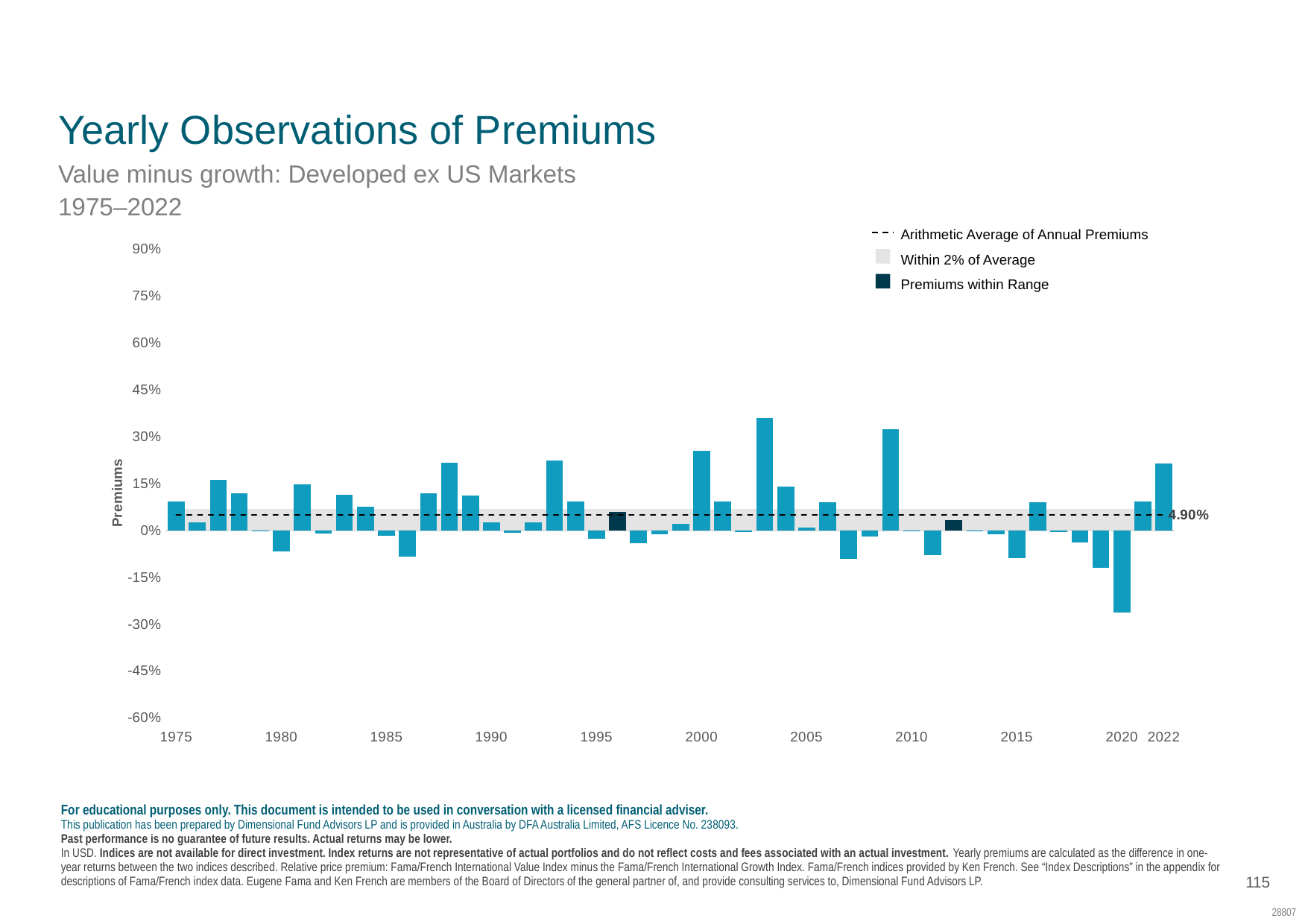
Which year has the larger premium, 1975 or 1980? 1975 Which year has the lowest premium on the chart? 2020 What does the dashed horizontal line on the chart represent? Arithmetic Average of Annual Premiums Which year has the larger premium, 2020 or 2022? 2022 How many entries does the chart legend list? 3 How many yearly observations does the chart cover, from 1975 to 2022? 48 Is the premium for 2022 greater or less than 15%? greater What is the arithmetic average of annual premiums shown on the chart? 4.90% Is the premium for 2020 greater or less than -15%? less Is the premium for 1980 greater or less than 0%? less What kind of chart is shown on the slide? bar chart